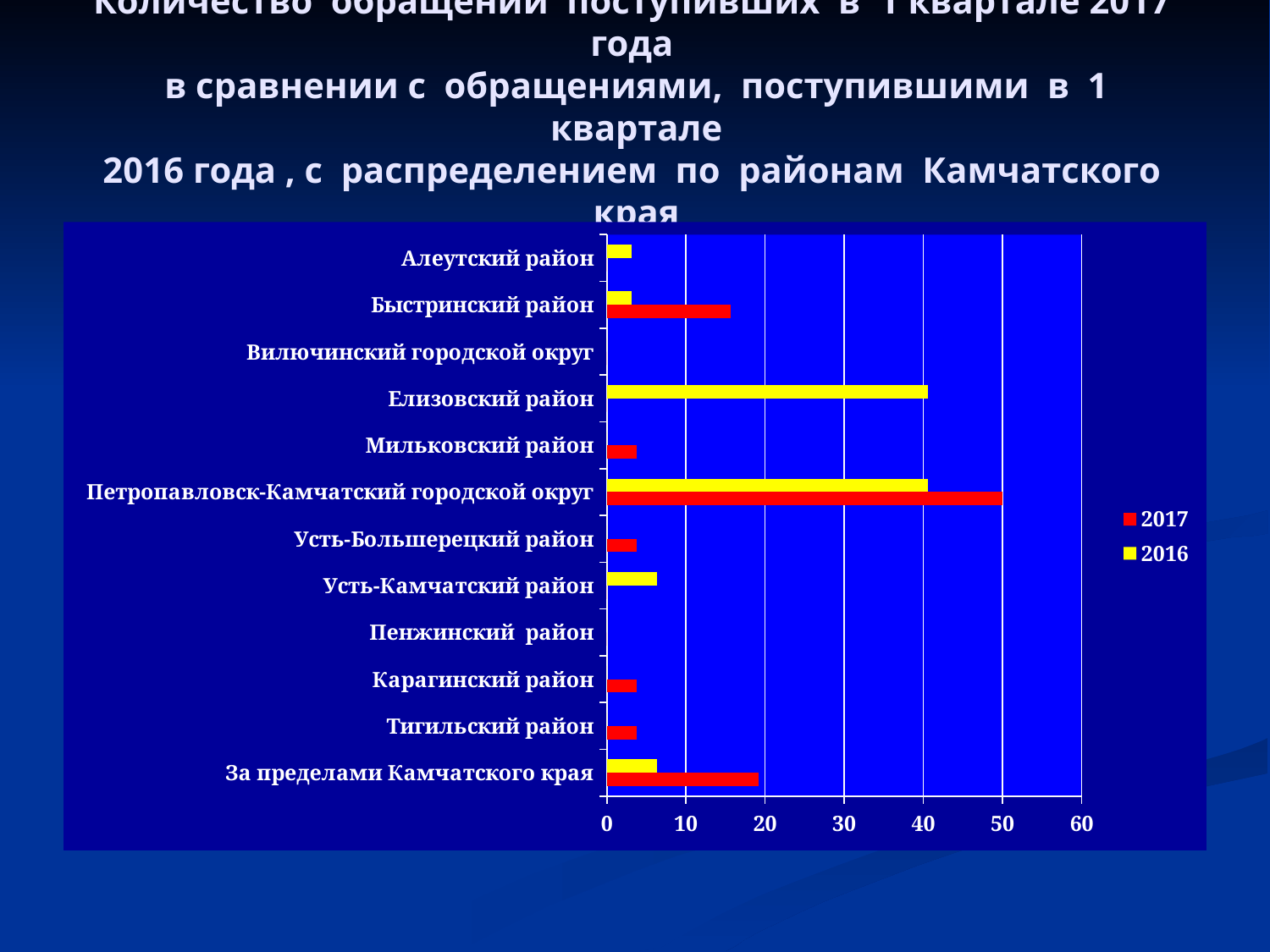
Which category has the highest value for the 2017 series? Петропавловск-Камчатский городской округ What kind of chart is shown on the slide? bar chart Is the 2017 value for Быстринский район greater or less than 20? less For Быстринский район, which series has the larger value, 2017 or 2016? 2017 Is the 2017 value for Петропавловск-Камчатский городской округ greater or less than 40? greater Which has the larger 2016 value, Елизовский район or Усть-Камчатский район? Елизовский район Is the 2017 value for За пределами Камчатского края greater or less than 10? greater What colour represents the 2017 series in the legend? red How many series does the legend list? 2 Which has the larger 2017 value, За пределами Камчатского края or Быстринский район? За пределами Камчатского края How many categories (districts) are shown on the chart? 12